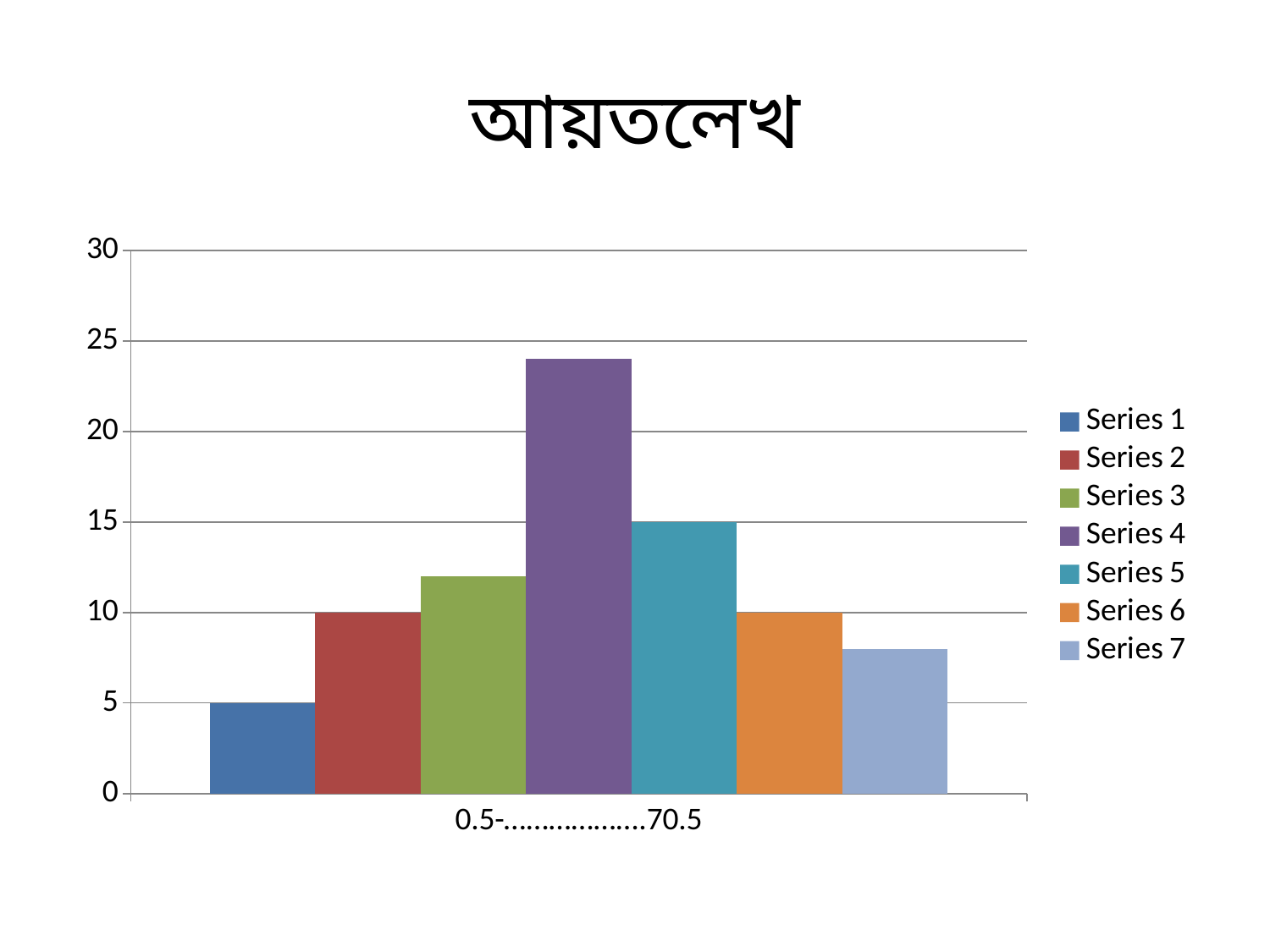
What is the difference between the values of Series 5 and Series 1? 10 What is the value of Series 5? 15 Is the value for Series 7 greater or less than 10? less Which is larger, the value for Series 5 or the value for Series 2? Series 5 What is the value of Series 2? 10 What kind of chart is shown on the slide? bar chart Is the value for Series 4 greater or less than 20? greater What is the value of Series 6? 10 What is the value of Series 1? 5 How many series does the legend list? 7 Which series has the lowest value? Series 1 Which series has the highest value? Series 4